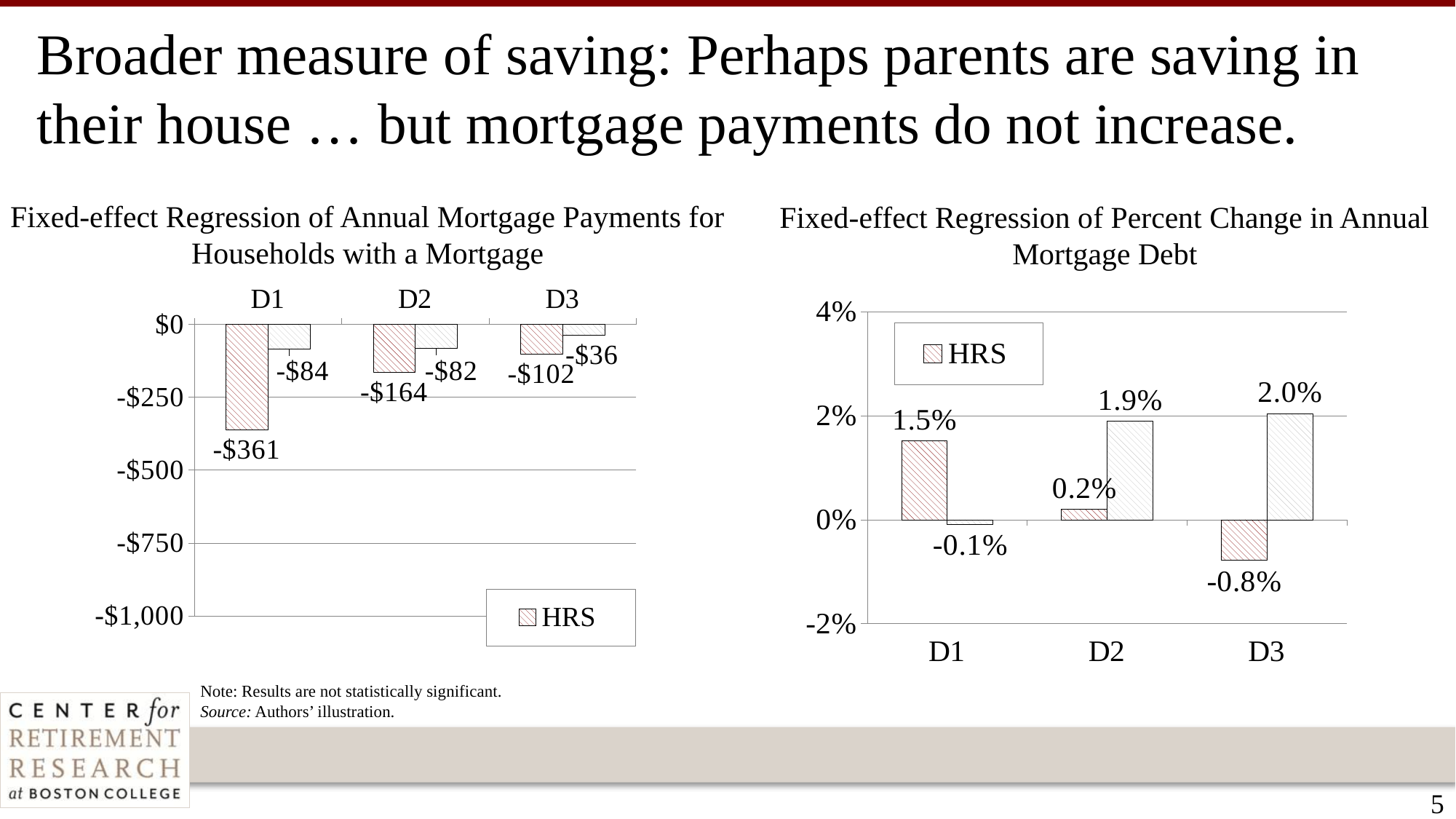
In the left chart, Fixed-effect Regression of Annual Mortgage Payments for Households with a Mortgage, how many categories are shown on the x axis? 3 In the left chart, Fixed-effect Regression of Annual Mortgage Payments for Households with a Mortgage, what is the HRS value for D1? -$361 What kind of chart is the right chart, Fixed-effect Regression of Percent Change in Annual Mortgage Debt? Bar chart In the left chart, Fixed-effect Regression of Annual Mortgage Payments for Households with a Mortgage, what is the value of the second (grey) bar for D3? -$36 In the left chart, Fixed-effect Regression of Annual Mortgage Payments for Households with a Mortgage, what is the difference between the HRS values for D1 and D2? $197 In the right chart, Fixed-effect Regression of Percent Change in Annual Mortgage Debt, what is the HRS value for D3? -0.8% In the right chart, Fixed-effect Regression of Percent Change in Annual Mortgage Debt, what is the value of the second (grey) bar for D2? 1.9% In the left chart, Fixed-effect Regression of Annual Mortgage Payments for Households with a Mortgage, which category has the lowest HRS value? D1 In the right chart, Fixed-effect Regression of Percent Change in Annual Mortgage Debt, is the HRS value for D1 larger or the HRS value for D2? D1 In the left chart, Fixed-effect Regression of Annual Mortgage Payments for Households with a Mortgage, what is the HRS value for D2? -$164 In the right chart, Fixed-effect Regression of Percent Change in Annual Mortgage Debt, what is the HRS value for D1? 1.5% In the right chart, Fixed-effect Regression of Percent Change in Annual Mortgage Debt, which category has the highest HRS value? D1